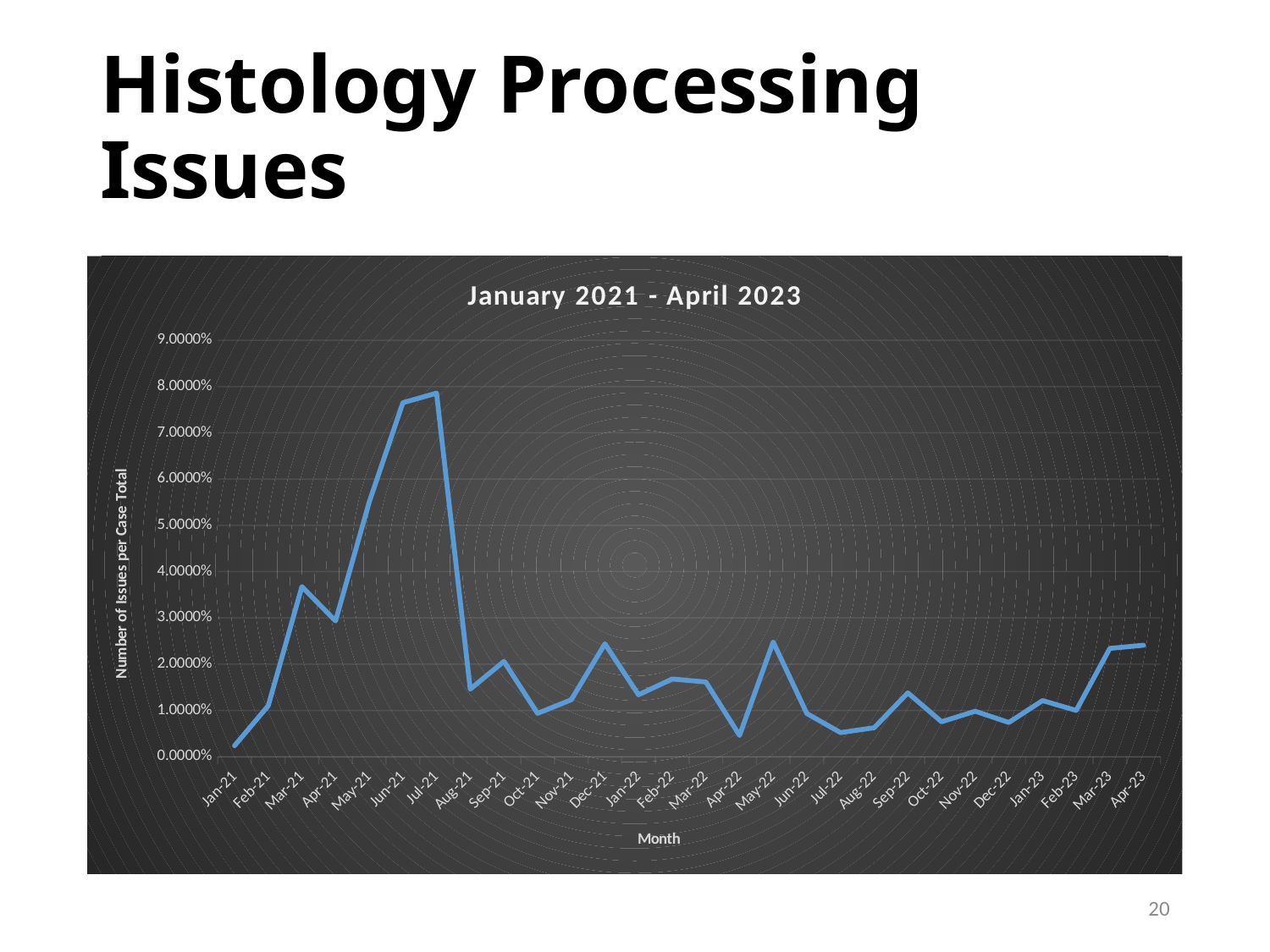
Is the value for Apr-22 greater or less than 1.0000%? less How many months are plotted along the x axis? 28 What kind of chart is shown on the slide? line chart Is the value for Mar-21 greater or less than 3.0000%? greater Which is larger, the value for Mar-21 or the value for Apr-21? Mar-21 Between Jul-21 and Aug-21, does the value rise or fall? fall Which month has the lowest value? Jan-21 Which month has the highest value? Jul-21 What is the label of the vertical axis? Number of Issues per Case Total Is the value for Jul-21 greater or less than 7.0000%? greater What is the title of the chart? January 2021 - April 2023